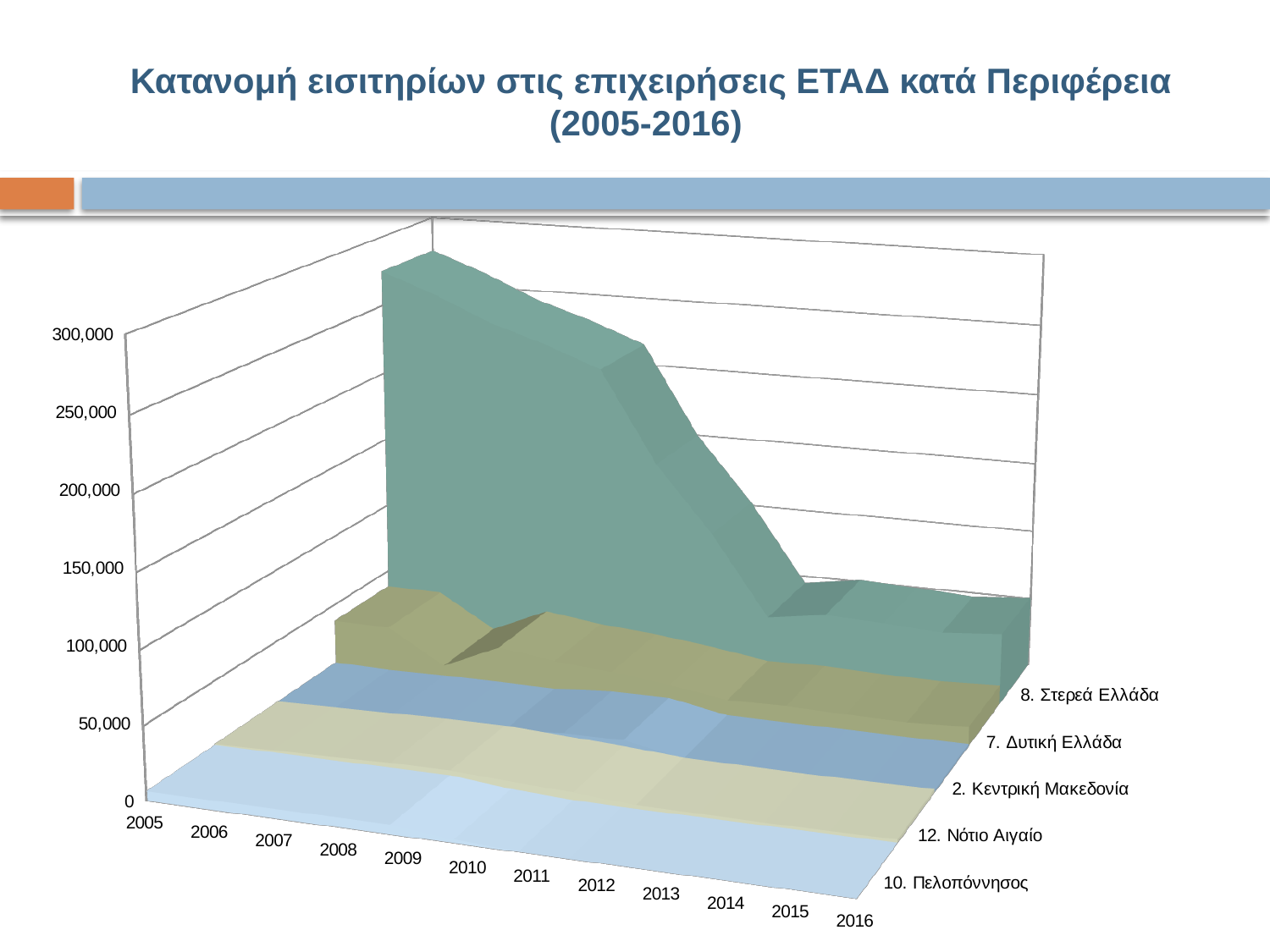
Which is larger, the value for 8. Στερεά Ελλάδα in 2010 or in 2015? 2010 Do the values for 8. Στερεά Ελλάδα rise or fall from 2010 to 2016? fall What is the title of the chart? Κατανομή εισιτηρίων στις επιχειρήσεις ΕΤΑΔ κατά Περιφέρεια (2005-2016) Which region has the lowest values across the chart? 10. Πελοπόννησος Is the value for 10. Πελοπόννησος in 2016 greater or less than 50,000? less What kind of chart is shown on the slide? area chart How many years are plotted along the x axis? 12 Is the value for 8. Στερεά Ελλάδα in 2009 greater or less than 200,000? greater How many series (regions) does the chart show? 5 Is the value for 8. Στερεά Ελλάδα in 2016 greater or less than 200,000? less Which region is plotted at the front of the 3D chart, closest to the viewer? 10. Πελοπόννησος Which region reaches the highest value in the chart? 8. Στερεά Ελλάδα